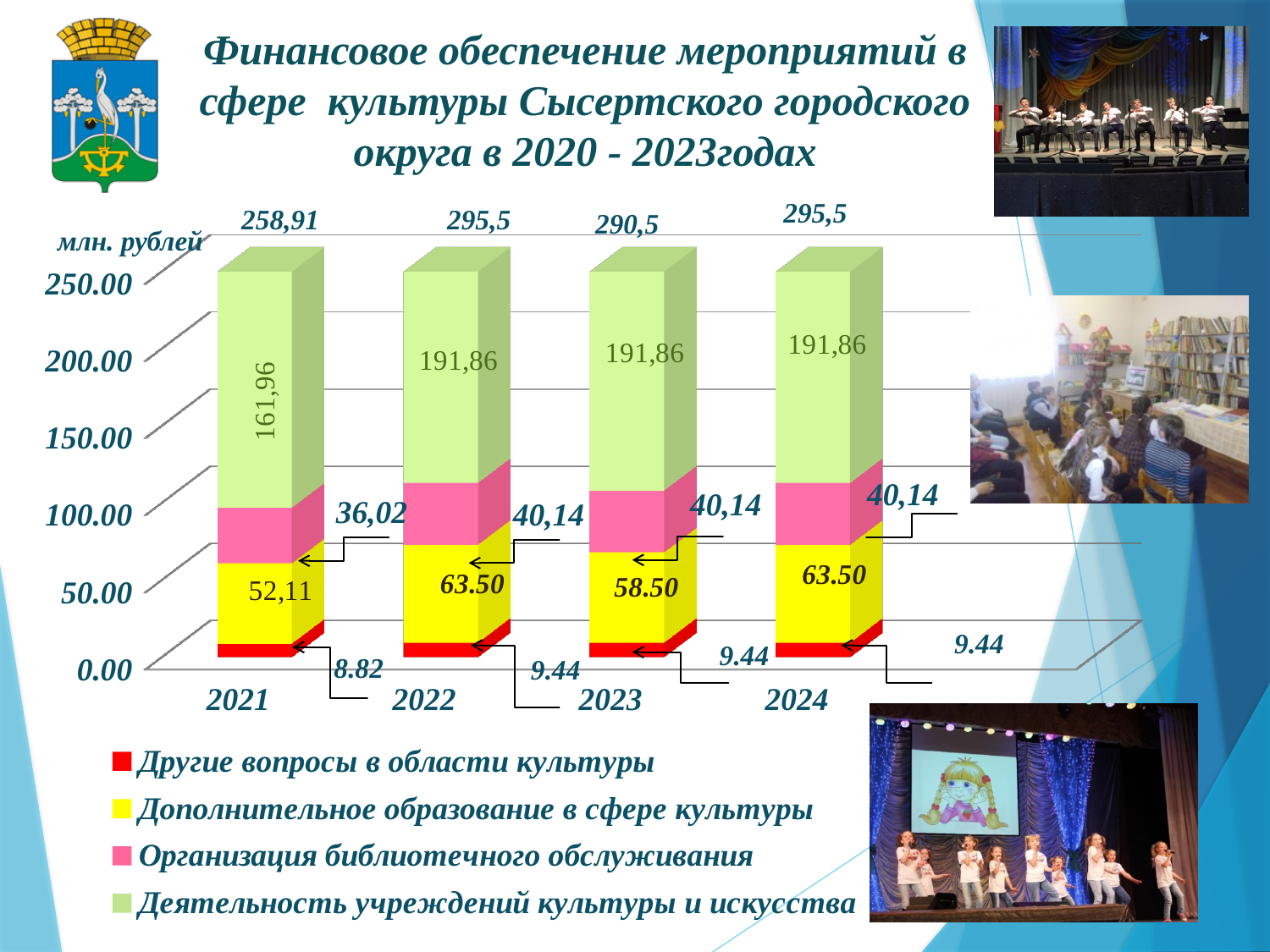
Which is larger: the value for 'Дополнительное образование в сфере культуры' in 2022 or in 2023? 2022 What is the value for 'Дополнительное образование в сфере культуры' in 2023? 58.50 What is the total value printed above the bar for 2021? 258,91 What type of chart is shown on the slide? stacked bar chart What is the difference between the total for 2022 and the total for 2023? 5 What is the value for 'Другие вопросы в области культуры' in 2021? 8.82 Which legend entry is shown in red? Другие вопросы в области культуры How many years (categories) are shown on the x axis of the chart? 4 What is the value for 'Организация библиотечного обслуживания' in 2021? 36,02 What is the value for 'Деятельность учреждений культуры и искусства' in 2021? 161,96 Which year has the lowest total value? 2021 How many series does the legend list? 4